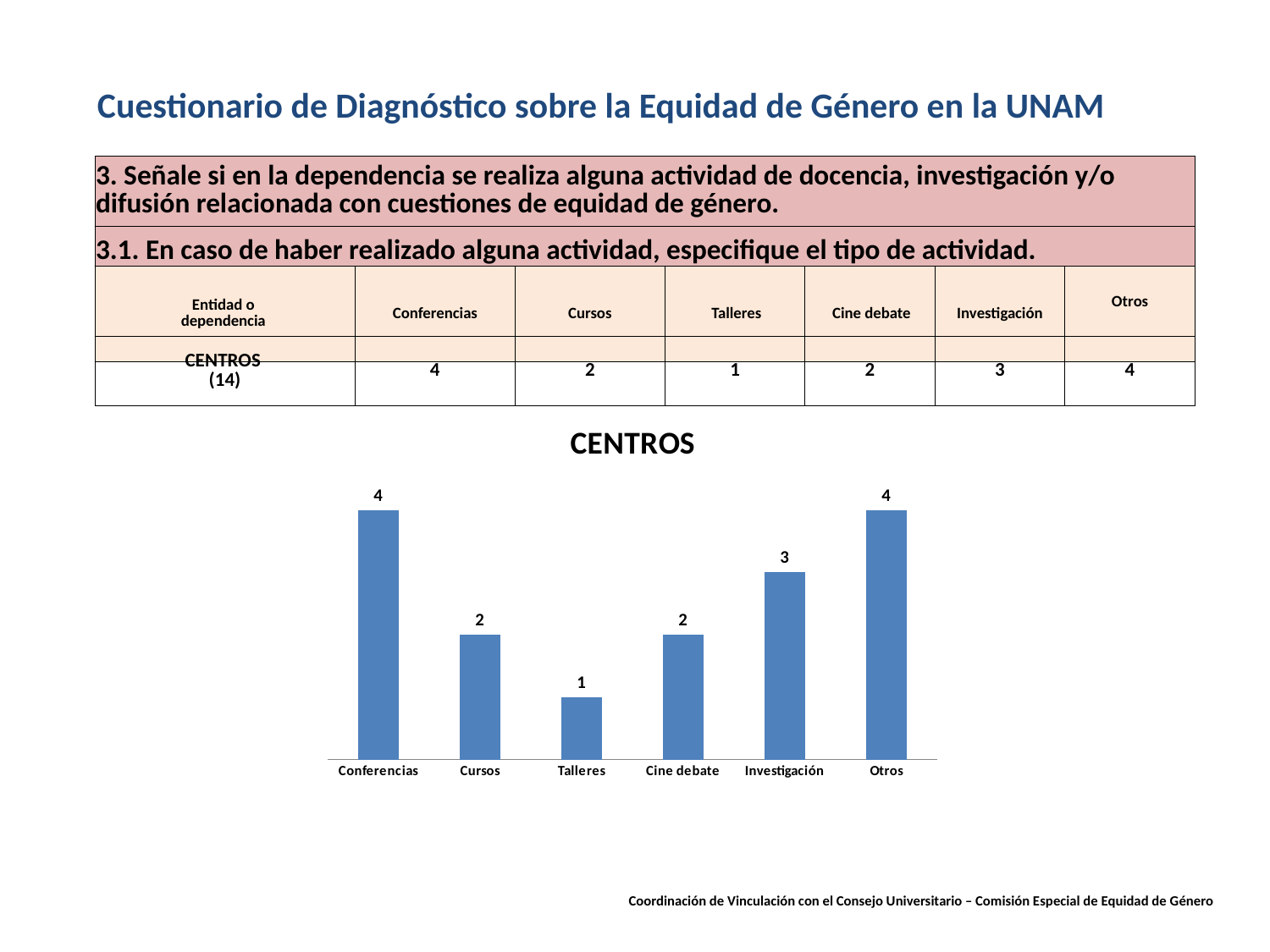
Which is larger in the CENTROS chart, the value for Investigación or the value for Cursos? Investigación Do the values in the CENTROS chart rise or fall from Talleres to Otros? Rise What is the value for Conferencias in the CENTROS chart? 4 What is the title of the chart on the slide? CENTROS What is the difference between the values for Investigación and Talleres in the CENTROS chart? 2 What is the value for Cine debate in the CENTROS chart? 2 What is the difference between the values for Conferencias and Cursos in the CENTROS chart? 2 What kind of chart is shown on the slide? Bar chart What is the value for Investigación in the CENTROS chart? 3 What is the value for Talleres in the CENTROS chart? 1 How many categories are shown in the CENTROS chart? 6 Which category has the lowest value in the CENTROS chart? Talleres